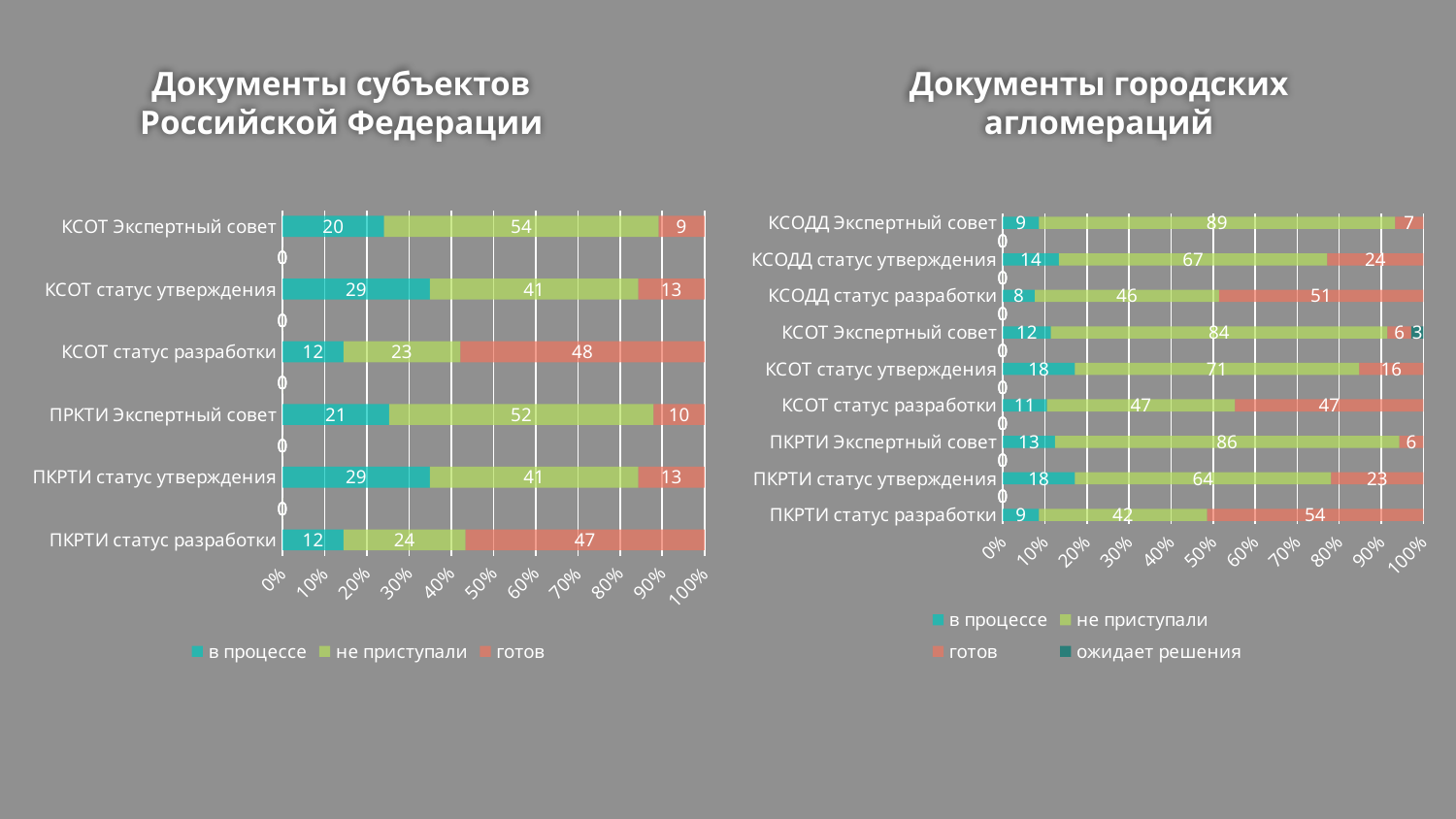
In the chart 'Документы субъектов Российской Федерации', what is the value of 'готов' for 'КСОТ статус разработки'? 48 In the chart 'Документы субъектов Российской Федерации', how many series does the legend list? 3 In the chart 'Документы городских агломераций', what is the value of 'не приступали' for 'КСОДД Экспертный совет'? 89 In the chart 'Документы субъектов Российской Федерации', how many categories are shown on the vertical axis? 6 In the chart 'Документы субъектов Российской Федерации', what is the value of 'в процессе' for 'ПКРТИ статус утверждения'? 29 What kind of chart is 'Документы субъектов Российской Федерации'? Stacked bar chart In the chart 'Документы городских агломераций', how many categories are shown on the vertical axis? 9 In the chart 'Документы городских агломераций', what is the value of 'готов' for 'ПКРТИ статус разработки'? 54 In the chart 'Документы городских агломераций', how many series does the legend list? 4 In the chart 'Документы субъектов Российской Федерации', what is the value of 'не приступали' for 'КСОТ Экспертный совет'? 54 In the chart 'Документы городских агломераций', which is larger: the 'готов' value for 'КСОДД статус разработки' or for 'КСОДД статус утверждения'? КСОДД статус разработки In the chart 'Документы городских агломераций', what is the value of 'в процессе' for 'КСОТ статус утверждения'? 18